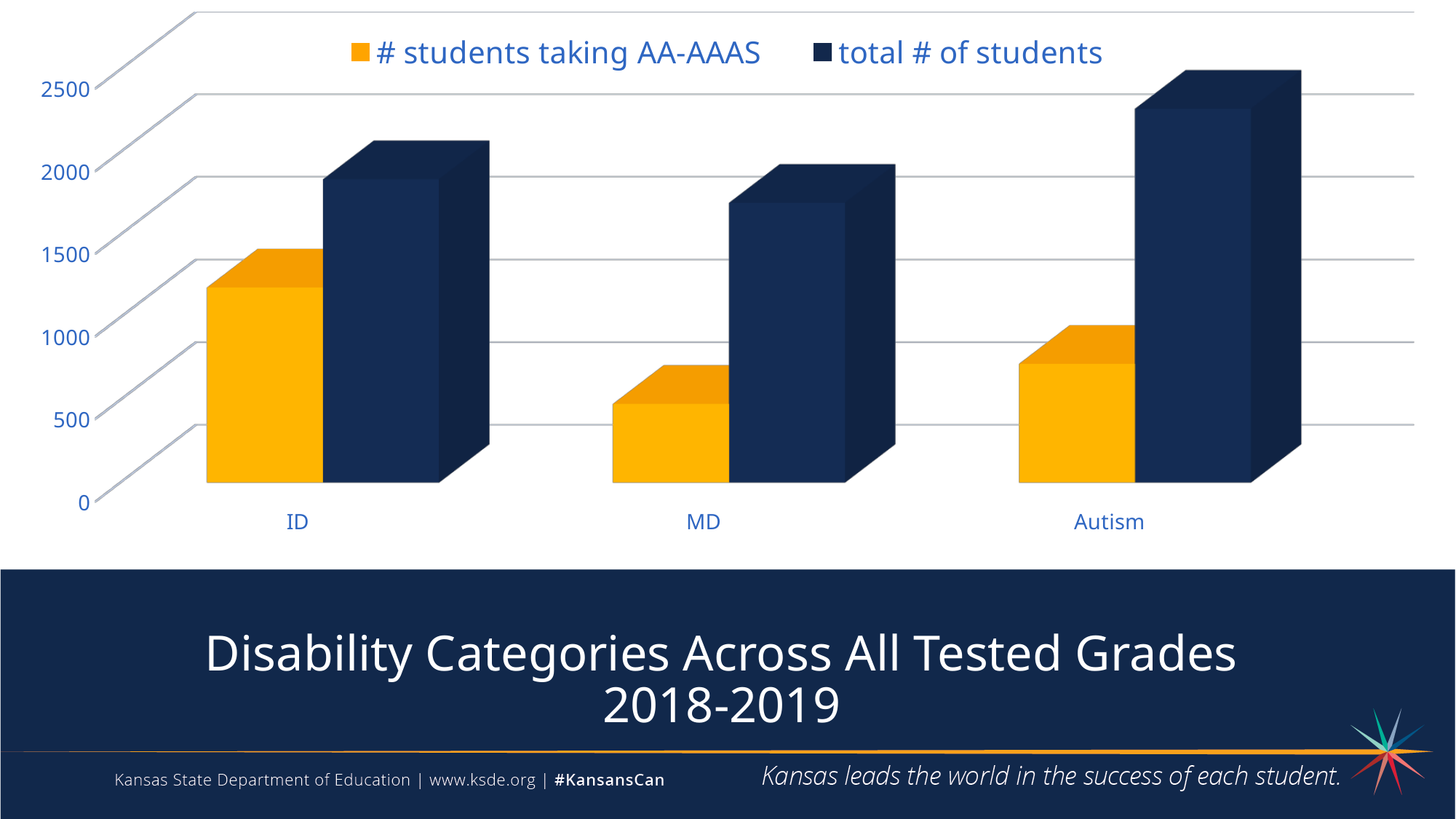
How many series does the legend list? 2 Is the value for # students taking AA-AAAS for ID greater or less than 1000? greater Is the value for # students taking AA-AAAS for Autism greater or less than 1000? less What kind of chart is shown on the slide? bar chart Is the value for total # of students for MD greater or less than 1500? greater Which category has the highest value for # students taking AA-AAAS? ID Which category has the highest value for total # of students? Autism How many disability categories are shown on the x axis? 3 Which colour represents the total # of students series? dark blue Which category has the lowest value for # students taking AA-AAAS? MD Which is larger: # students taking AA-AAAS for ID or for Autism? ID